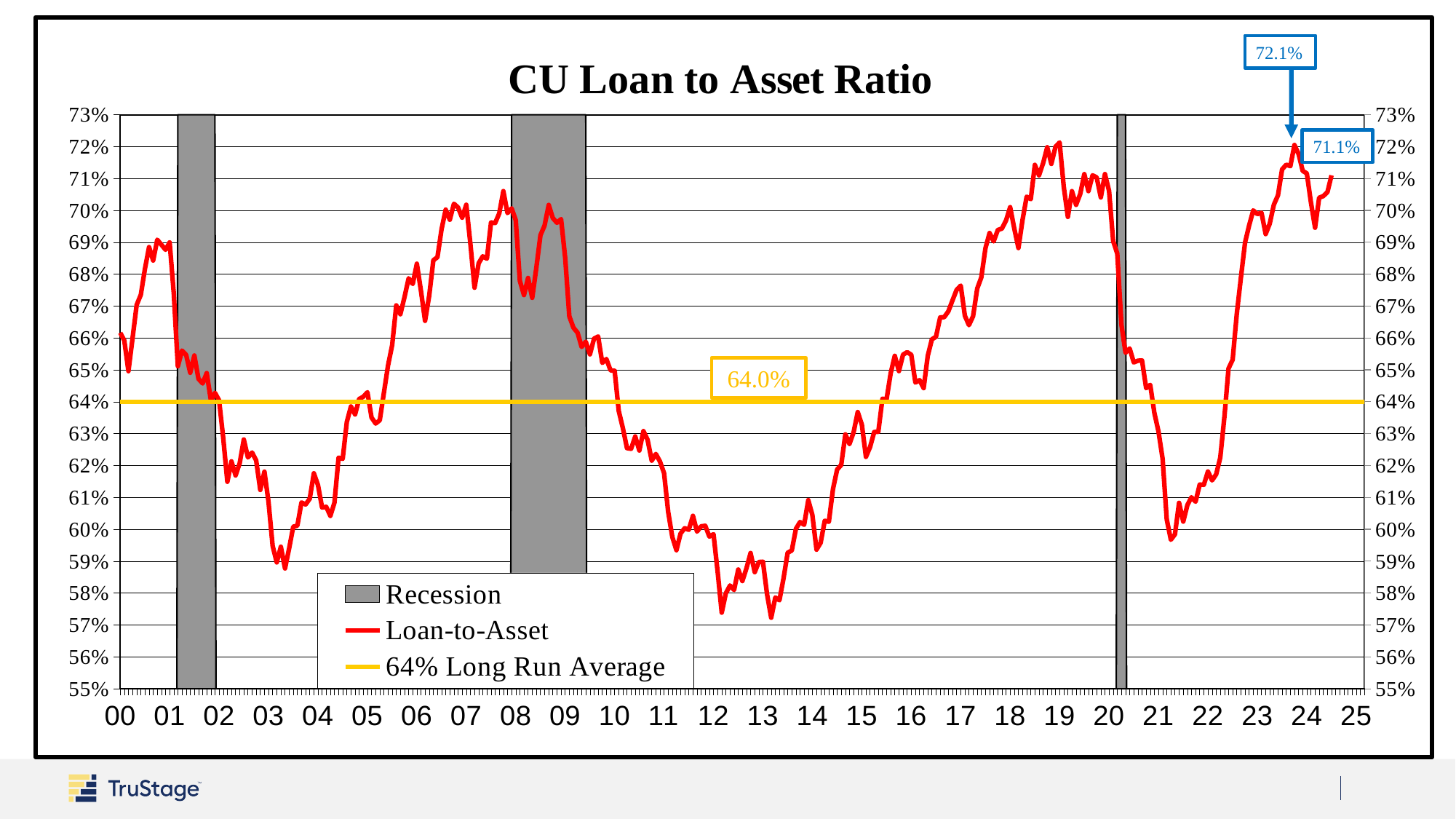
What is the most recent Loan-to-Asset value labelled at the end of the line? 71.1% How many entries does the chart's legend list? 3 What value is labelled on the long run average line? 64.0% How many recession periods are shaded on the chart? 3 Is the Loan-to-Asset value at the start of 2000 greater or less than 65%? greater What kind of chart is shown on the slide? line chart Does the Loan-to-Asset line rise or fall between 2021 and 2024? rise What is the difference between the labelled peak of 72.1% and the latest labelled value of 71.1%? 1.0% How far above the 64.0% long run average is the labelled peak of 72.1%? 8.1% What is the title of the chart? CU Loan to Asset Ratio What is the peak value of the Loan-to-Asset line labelled near 2024? 72.1% Is the lowest Loan-to-Asset value around 2013 greater or less than 58%? less